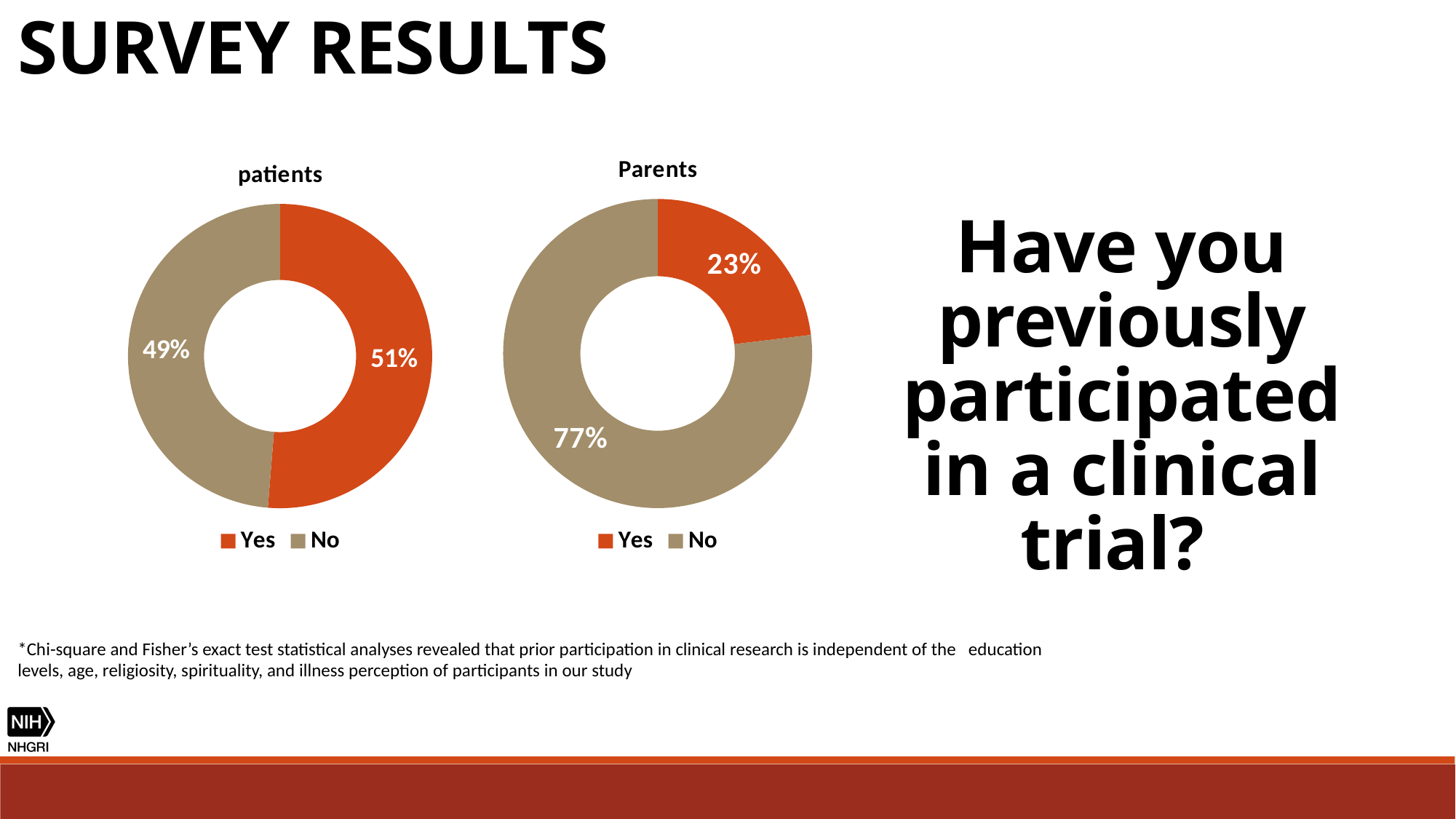
In the 'Parents' chart, what percentage answered No? 77% In the 'Parents' chart, what percentage answered Yes? 23% In the 'Parents' chart, what is the difference between the No and Yes percentages? 54% In the 'patients' chart, what colour represents the Yes response? Orange-red In the 'Parents' chart, which response has the largest share? No In the 'patients' chart, what percentage answered No? 49% In the 'patients' chart, what is the difference between the Yes and No percentages? 2% Is the Yes share in the 'patients' chart larger or smaller than the Yes share in the 'Parents' chart? larger What kind of chart is the 'Parents' chart? Doughnut chart In the 'Parents' chart, which response has the smallest share? Yes How many categories does the legend of the 'patients' chart list? 2 In the 'patients' chart, what percentage answered Yes? 51%